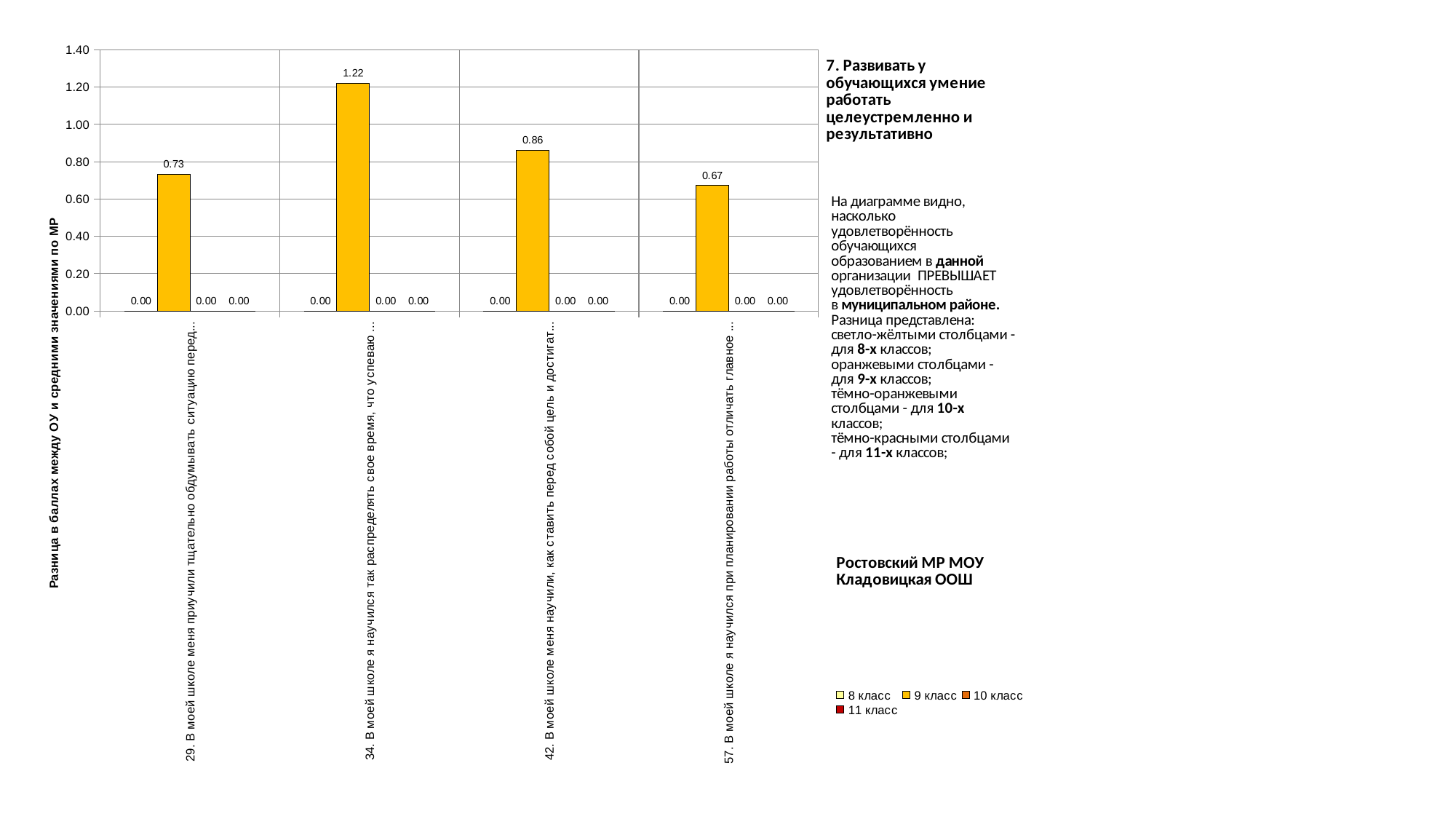
For which statement is the 9 класс value lowest? 57 What is the difference between the 9 класс values for statements 34 and 29? 0.49 What is the value for 9 класс for statement 34? 1.22 What is the value for 9 класс for statement 29? 0.73 How many series does the legend list? 4 Which is larger: the 9 класс value for statement 42 or for statement 57? statement 42 What type of chart is shown on the slide? bar chart What is the value for 8 класс for statement 34? 0.00 What is the value for 9 класс for statement 42? 0.86 What is the value for 9 класс for statement 57? 0.67 How many categories (statements) are shown on the x axis? 4 For which statement is the 9 класс value highest? 34